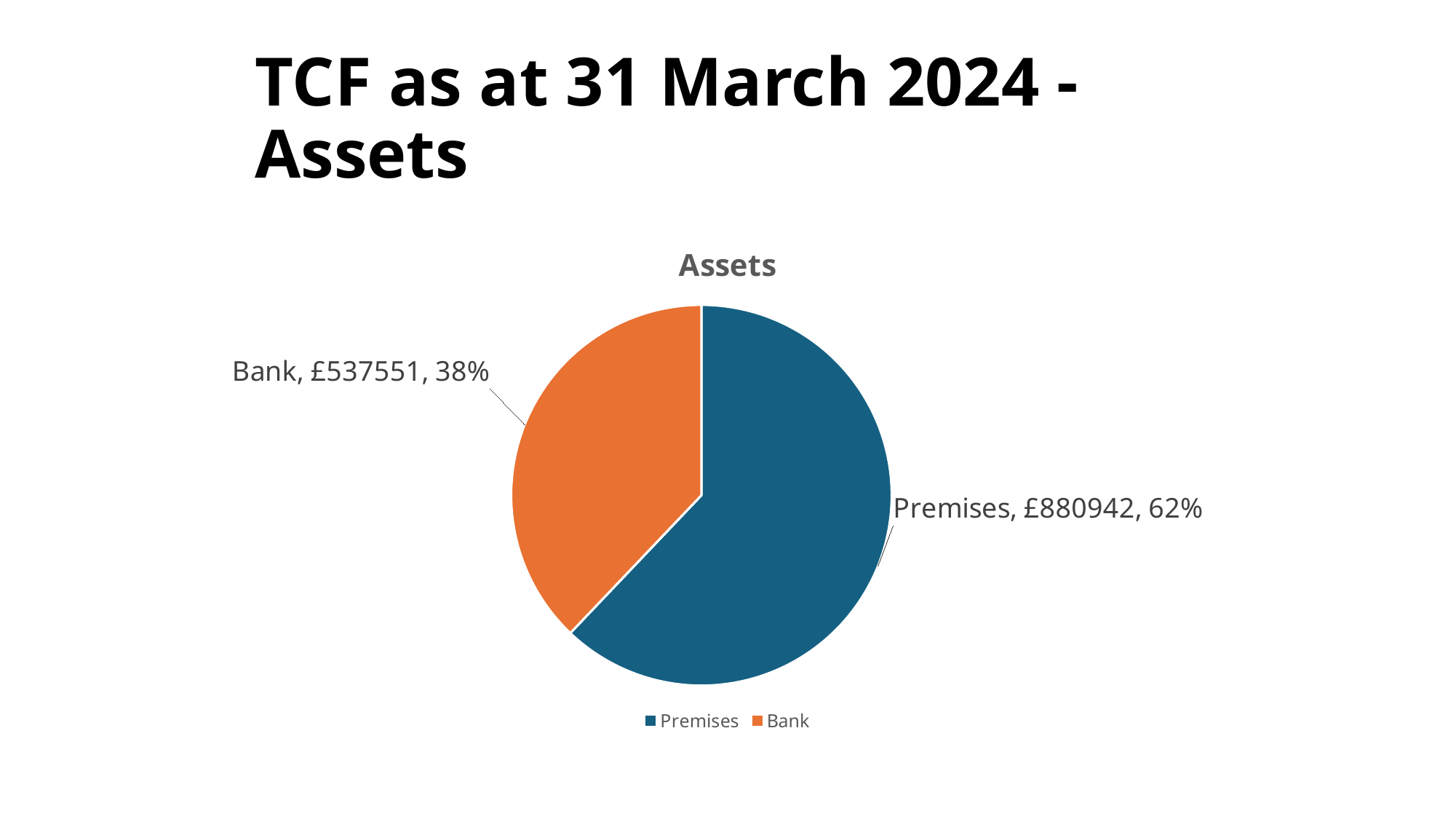
Which category has the largest slice? Premises What is the value for Premises? £880942 What is the difference between the Premises value and the Bank value? £343391 Which category has the smallest slice? Bank What is the value for Bank? £537551 What share of the pie does Bank represent? 38% What is the title of the chart? Assets Which is larger, Premises or Bank? Premises What is the total of the Premises and Bank values? £1418493 How many slices does the pie chart have? 2 What share of the pie does Premises represent? 62% What type of chart is shown on the slide? pie chart